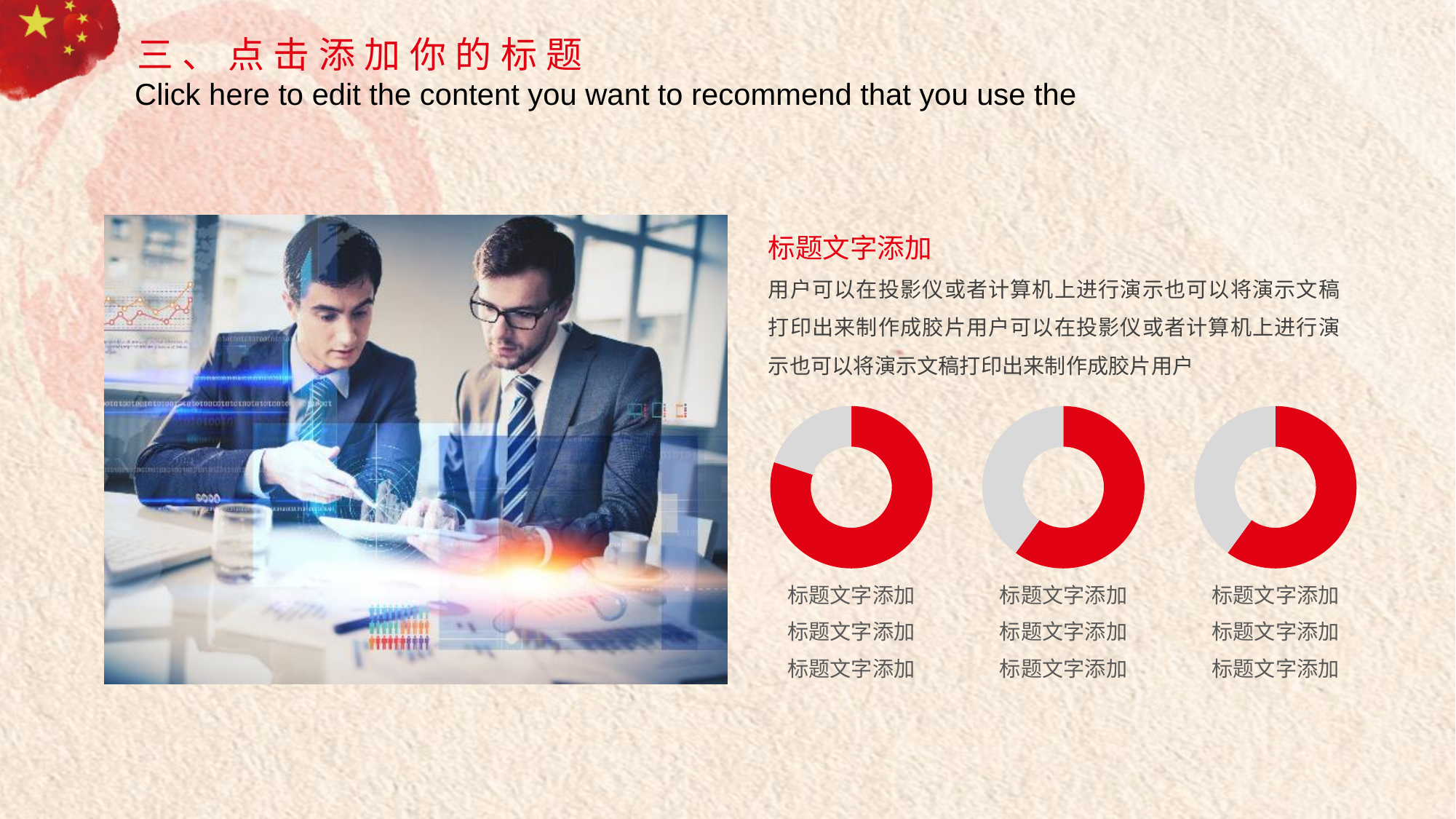
Is the red segment larger in the left donut chart or in the right donut chart? Left In the middle donut chart, is the red segment larger or smaller than the grey segment? Larger Do the donut charts display any numeric data labels? No How many segments does each donut chart have? 2 What two colours are used in the donut charts? Red and grey Which donut chart has the largest red segment: the left, middle, or right one? Left How many donut charts are on the slide? 3 What kind of charts are shown on the right side of the slide? Donut charts In the left donut chart, is the red segment larger or smaller than the grey segment? Larger